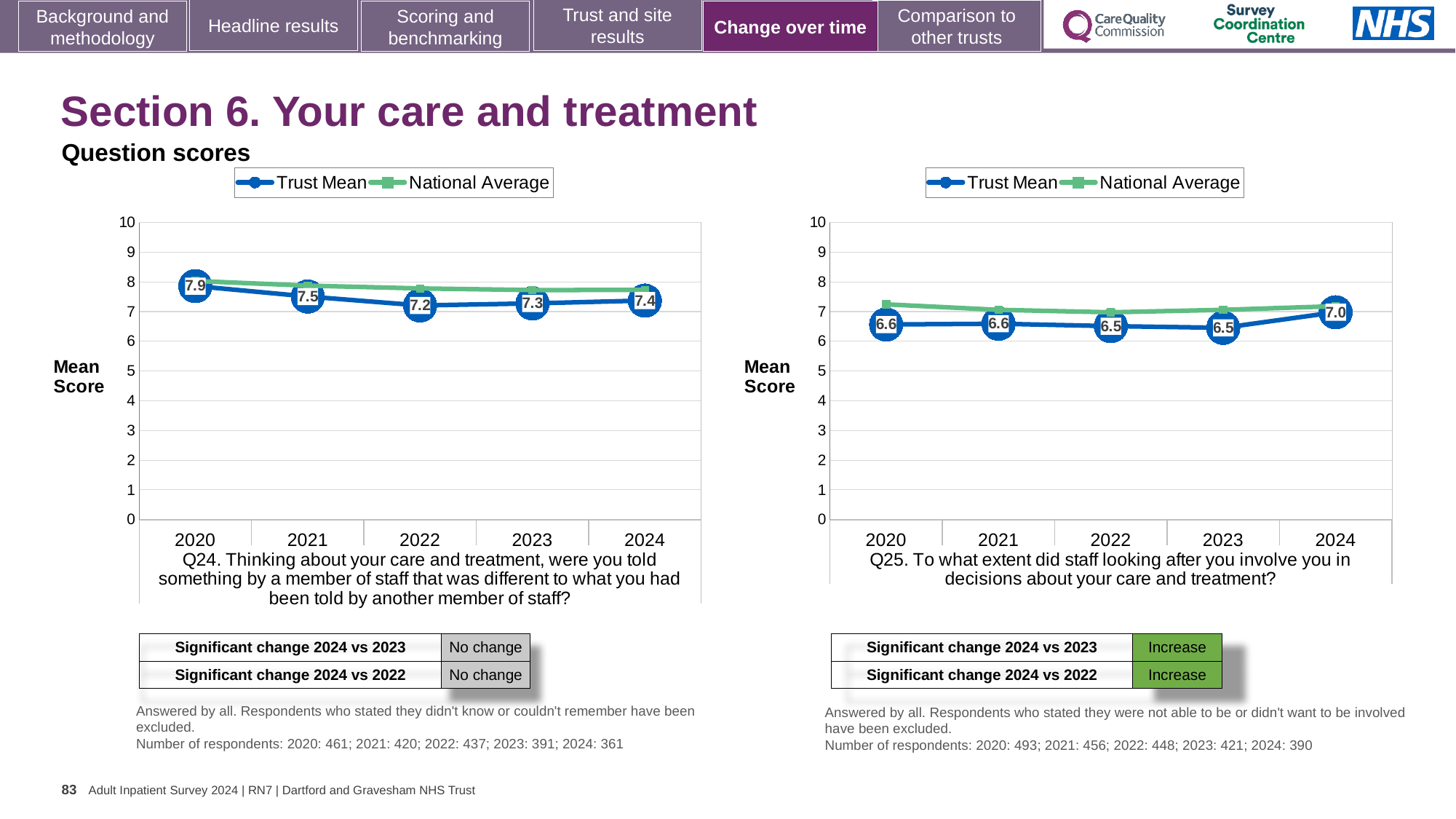
On the Q25 chart (right), what is the Trust Mean score for 2022? 6.5 On the Q24 chart (left), what is the difference between the Trust Mean scores for 2020 and 2022? 0.7 On the Q24 chart (left), is the Trust Mean score for 2021 greater or less than 7? greater On the Q25 chart (right), which year has the highest Trust Mean score? 2024 On the Q24 chart (left), what is the Trust Mean score for 2020? 7.9 How many years are plotted on the x axis of the Q24 chart (left)? 5 On the Q25 chart (right), what is the difference between the Trust Mean scores for 2024 and 2023? 0.5 On the Q25 chart (right), what is the Trust Mean score for 2024? 7.0 How many series does the legend list on the Q25 chart (right)? 2 On the Q24 chart (left), what is the Trust Mean score for 2022? 7.2 On the Q24 chart (left), which year has the highest Trust Mean score? 2020 What kind of chart is the Q25 chart (right)? Line chart